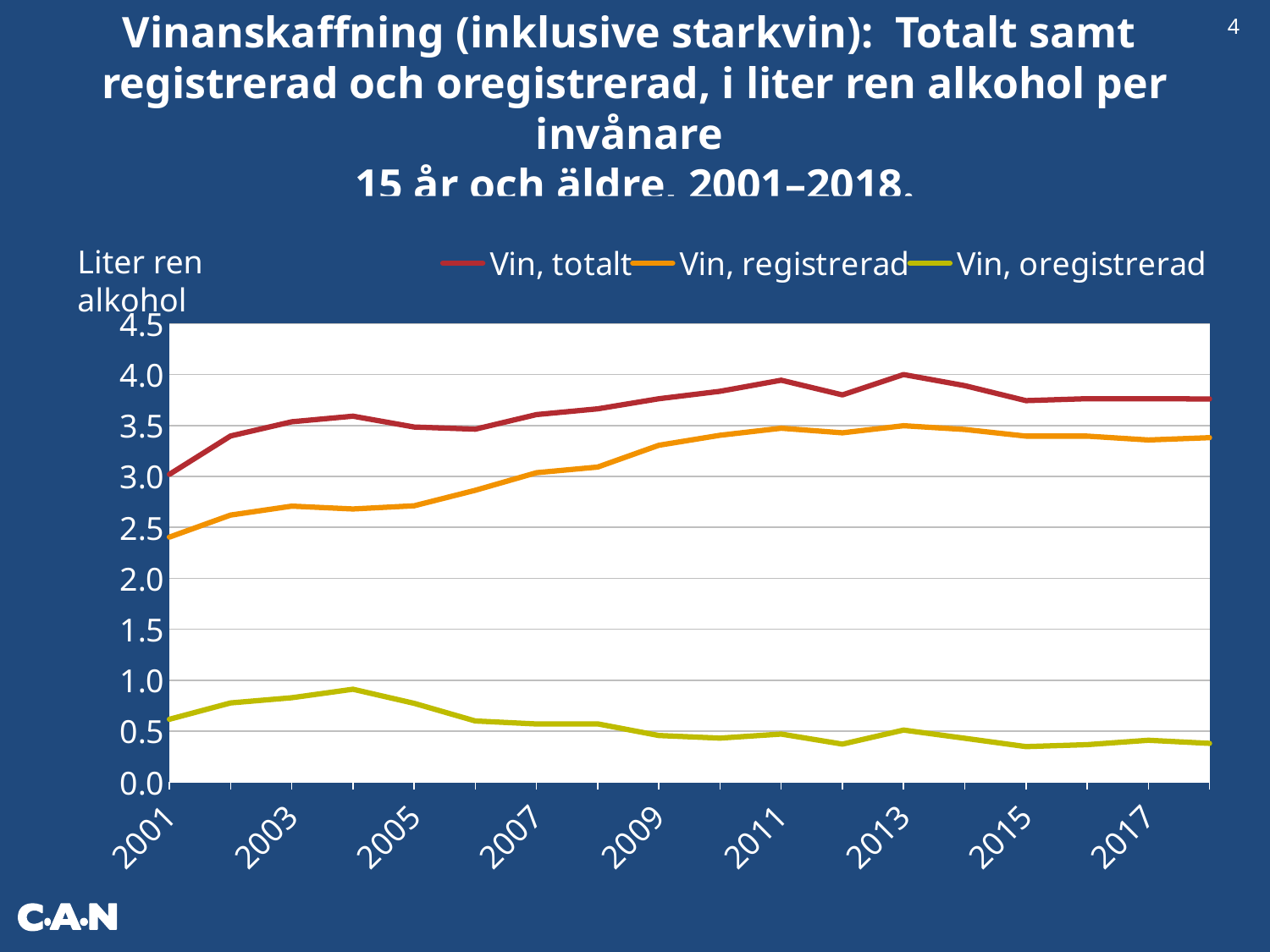
Is the value for Vin, oregistrerad in 2004 greater or less than 0.5? greater How many series does the legend list? 3 Which series is drawn in red? Vin, totalt Does Vin, registrerad rise or fall from 2001 to 2011? rise In which year is Vin, oregistrerad highest? 2004 Is the value for Vin, registrerad in 2018 greater or less than 3.0? greater In which year is Vin, registrerad lowest? 2001 Is the value for Vin, totalt in 2013 greater or less than 3.5? greater Which is larger for Vin, totalt: the value in 2001 or the value in 2018? 2018 How many years are plotted on the x axis? 18 What kind of chart is shown on the slide? line chart